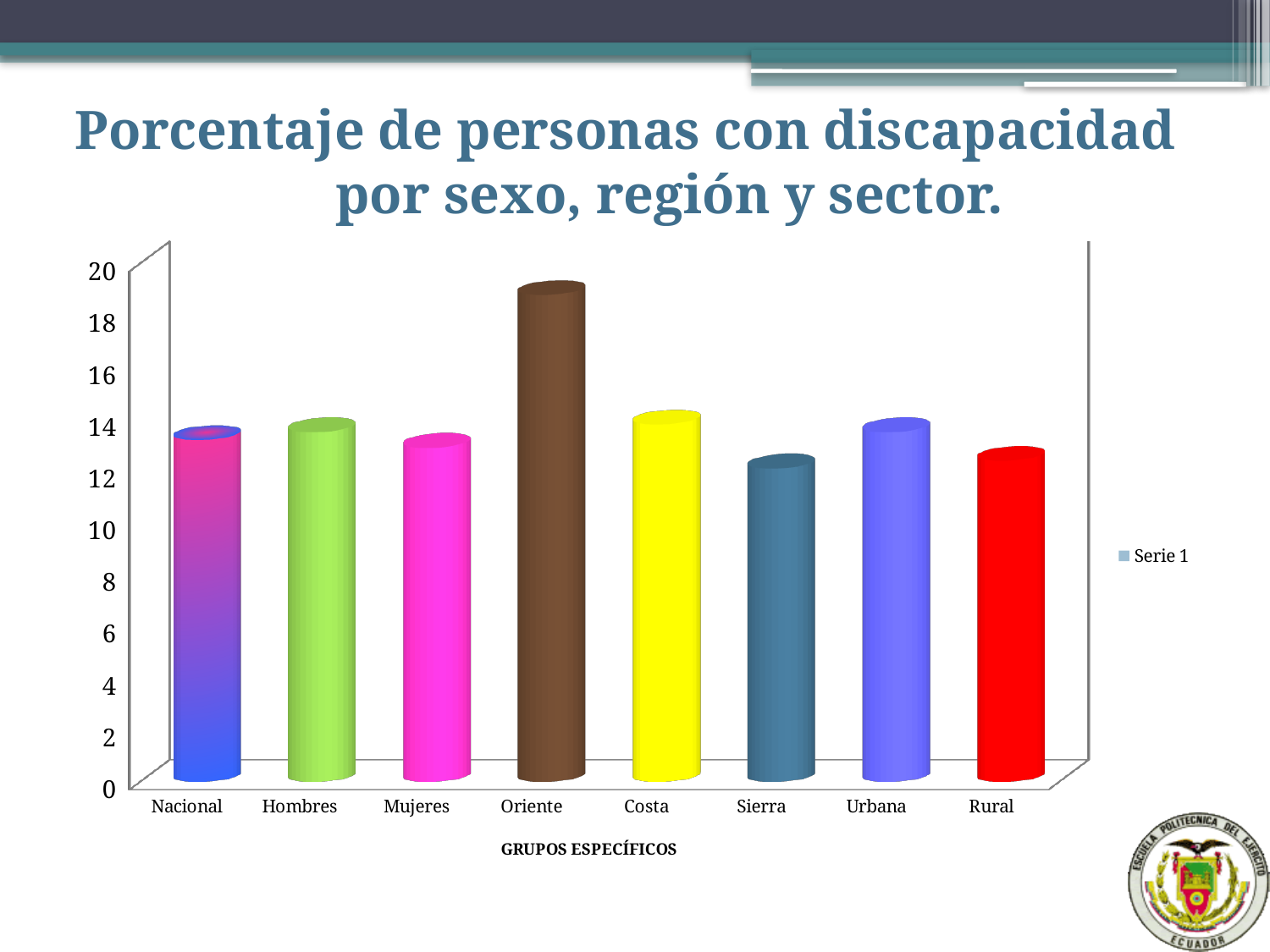
What is the title of the x axis of the chart? GRUPOS ESPECÍFICOS Which category has the highest value in the chart? Oriente Is the value for Sierra greater or less than 14? less Is the value for Costa greater or less than 12? greater Which category has the lowest value in the chart? Sierra Which is larger, the value for Oriente or the value for Costa? Oriente How many series does the legend list? 1 Which is larger, the value for Costa or the value for Sierra? Costa Is the value for Oriente greater or less than 16? greater What kind of chart is shown on the slide? Bar chart How many categories are shown on the x axis of the chart? 8